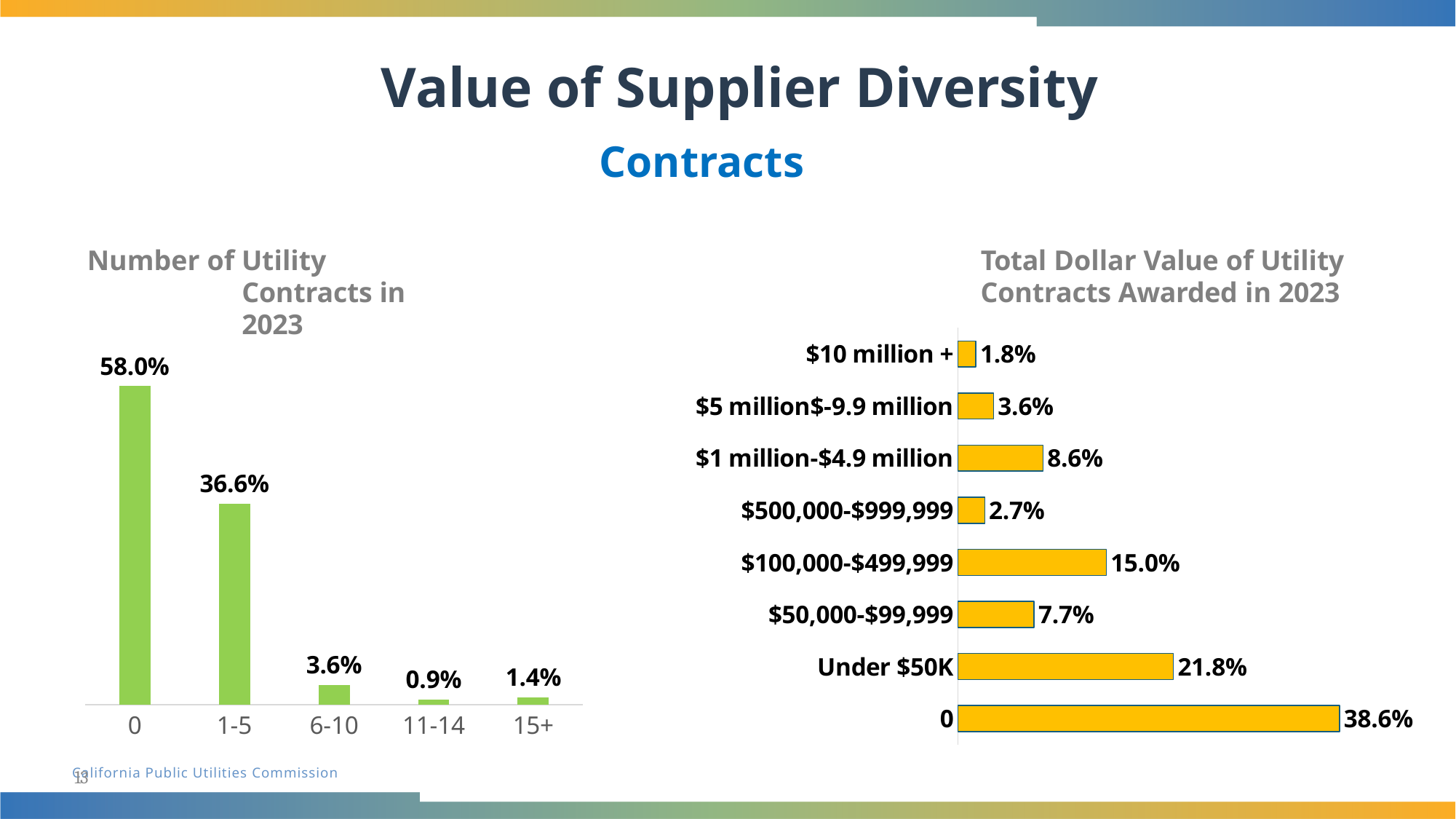
In the 'Total Dollar Value of Utility Contracts Awarded in 2023' chart, what is the difference between 'Under $50K' and '$100,000-$499,999'? 6.8% In the 'Total Dollar Value of Utility Contracts Awarded in 2023' chart, which is larger: '$1 million-$4.9 million' or '$50,000-$99,999'? $1 million-$4.9 million In the 'Total Dollar Value of Utility Contracts Awarded in 2023' chart, what is the value for '$100,000-$499,999'? 15.0% In the 'Number of Utility Contracts in 2023' chart, how many categories are shown on the x axis? 5 In the 'Number of Utility Contracts in 2023' chart, what percentage is shown for the '0' category? 58.0% In the 'Total Dollar Value of Utility Contracts Awarded in 2023' chart, what is the value for '$10 million +'? 1.8% What type of chart is the 'Total Dollar Value of Utility Contracts Awarded in 2023' chart? Bar chart In the 'Total Dollar Value of Utility Contracts Awarded in 2023' chart, how many categories are shown? 8 In the 'Number of Utility Contracts in 2023' chart, what is the difference between the '0' and '1-5' categories? 21.4% In the 'Number of Utility Contracts in 2023' chart, what is the value for the '6-10' category? 3.6% In the 'Number of Utility Contracts in 2023' chart, which category has the lowest value? 11-14 In the 'Total Dollar Value of Utility Contracts Awarded in 2023' chart, which category has the highest value? 0